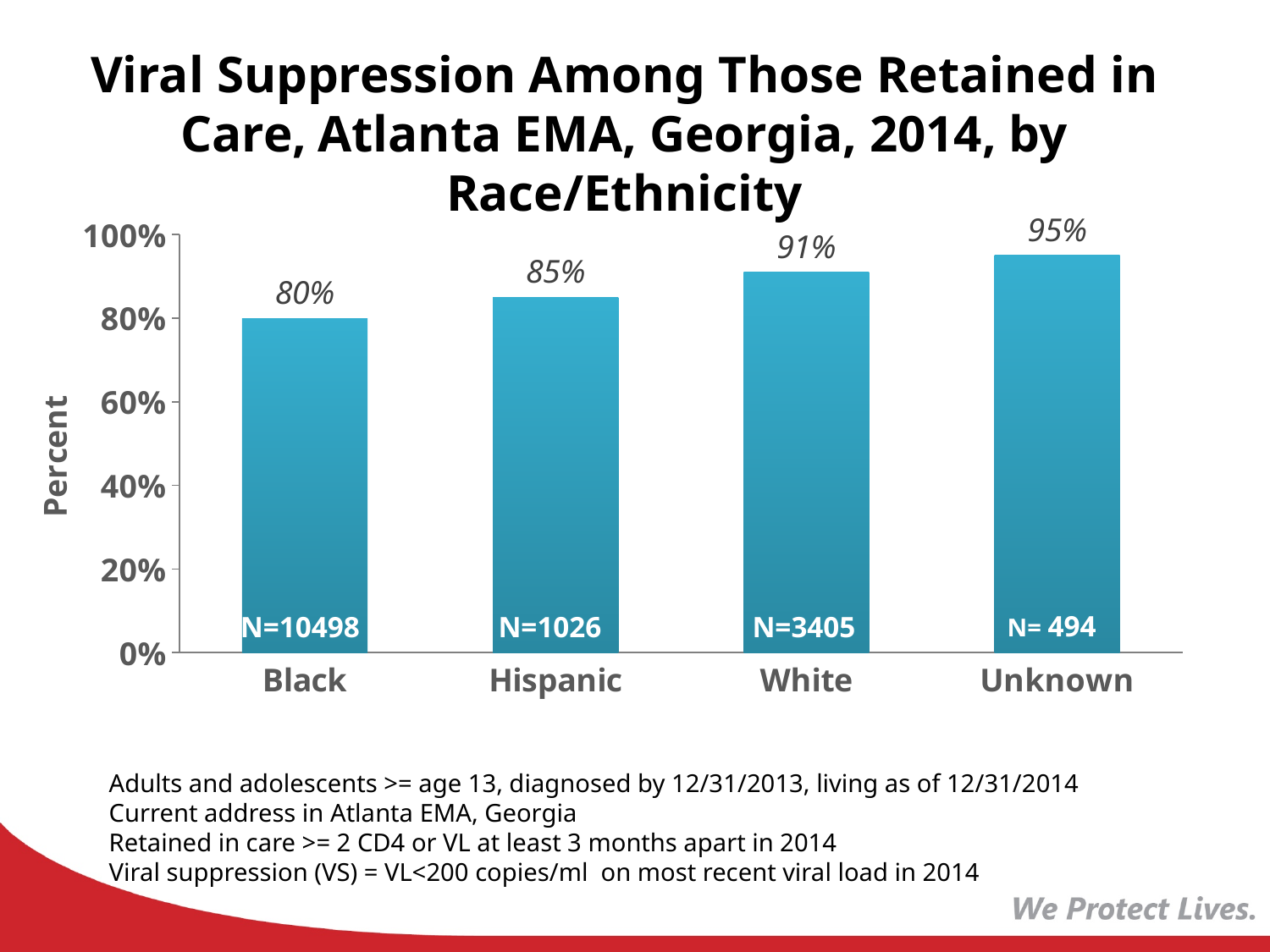
What type of chart is shown on the slide? Bar chart What is the difference in viral suppression percentage between White and Black individuals? 11% What is the viral suppression percentage for White individuals? 91% What is the viral suppression percentage for the Unknown race/ethnicity group? 95% What is the N value shown for the Black group? N=10498 Which group has a higher viral suppression percentage, Hispanic or White? White What is the viral suppression percentage for Hispanic individuals? 85% What is the viral suppression percentage for Black individuals? 80% How many race/ethnicity categories are shown in the chart? 4 Which race/ethnicity group has the highest viral suppression percentage? Unknown What is the label on the y-axis of the chart? Percent Which race/ethnicity group has the lowest viral suppression percentage? Black